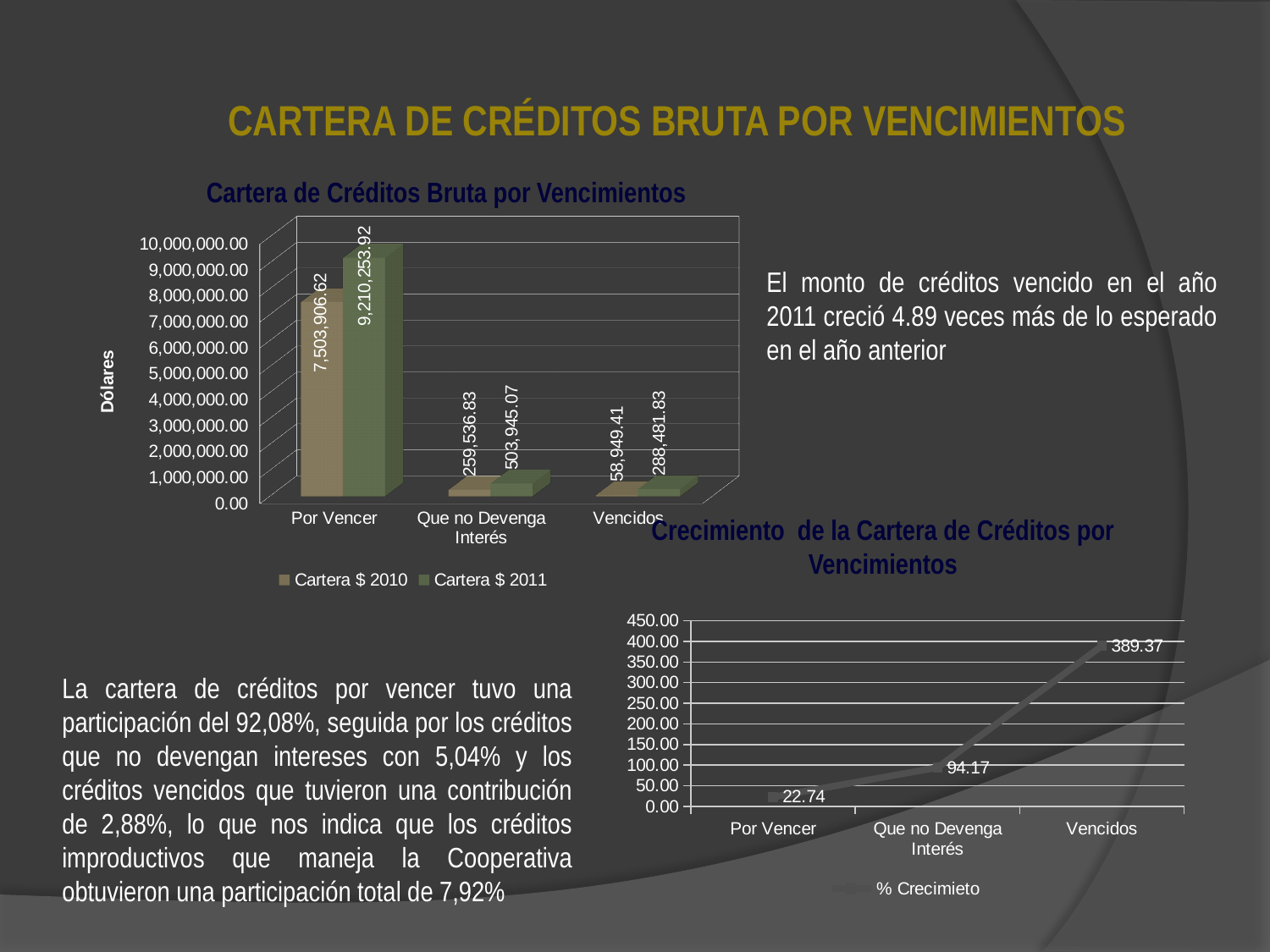
In the chart titled 'Crecimiento de la Cartera de Créditos por Vencimientos', what is the value for Por Vencer? 22.74 In the chart titled 'Cartera de Créditos Bruta por Vencimientos', what is the value for Vencidos in the Cartera $ 2010 series? 58,949.41 In the chart titled 'Cartera de Créditos Bruta por Vencimientos', how many series does the legend list? 2 In the chart titled 'Cartera de Créditos Bruta por Vencimientos', what is the value for Por Vencer in the Cartera $ 2011 series? 9,210,253.92 In the chart titled 'Cartera de Créditos Bruta por Vencimientos', what kind of chart is it? Bar chart In the chart titled 'Cartera de Créditos Bruta por Vencimientos', what is the difference between the Cartera $ 2011 and Cartera $ 2010 values for Por Vencer? 1,706,347.30 In the chart titled 'Crecimiento de la Cartera de Créditos por Vencimientos', what is the difference between the values for Vencidos and Por Vencer? 366.63 In the chart titled 'Cartera de Créditos Bruta por Vencimientos', what is the value for Que no Devenga Interés in the Cartera $ 2011 series? 503,945.07 In the chart titled 'Cartera de Créditos Bruta por Vencimientos', which category has the lowest value in the Cartera $ 2011 series? Vencidos In the chart titled 'Crecimiento de la Cartera de Créditos por Vencimientos', do the values rise or fall from Por Vencer to Vencidos? Rise In the chart titled 'Crecimiento de la Cartera de Créditos por Vencimientos', what is the value for Vencidos? 389.37 In the chart titled 'Cartera de Créditos Bruta por Vencimientos', which category has the highest value in the Cartera $ 2010 series? Por Vencer